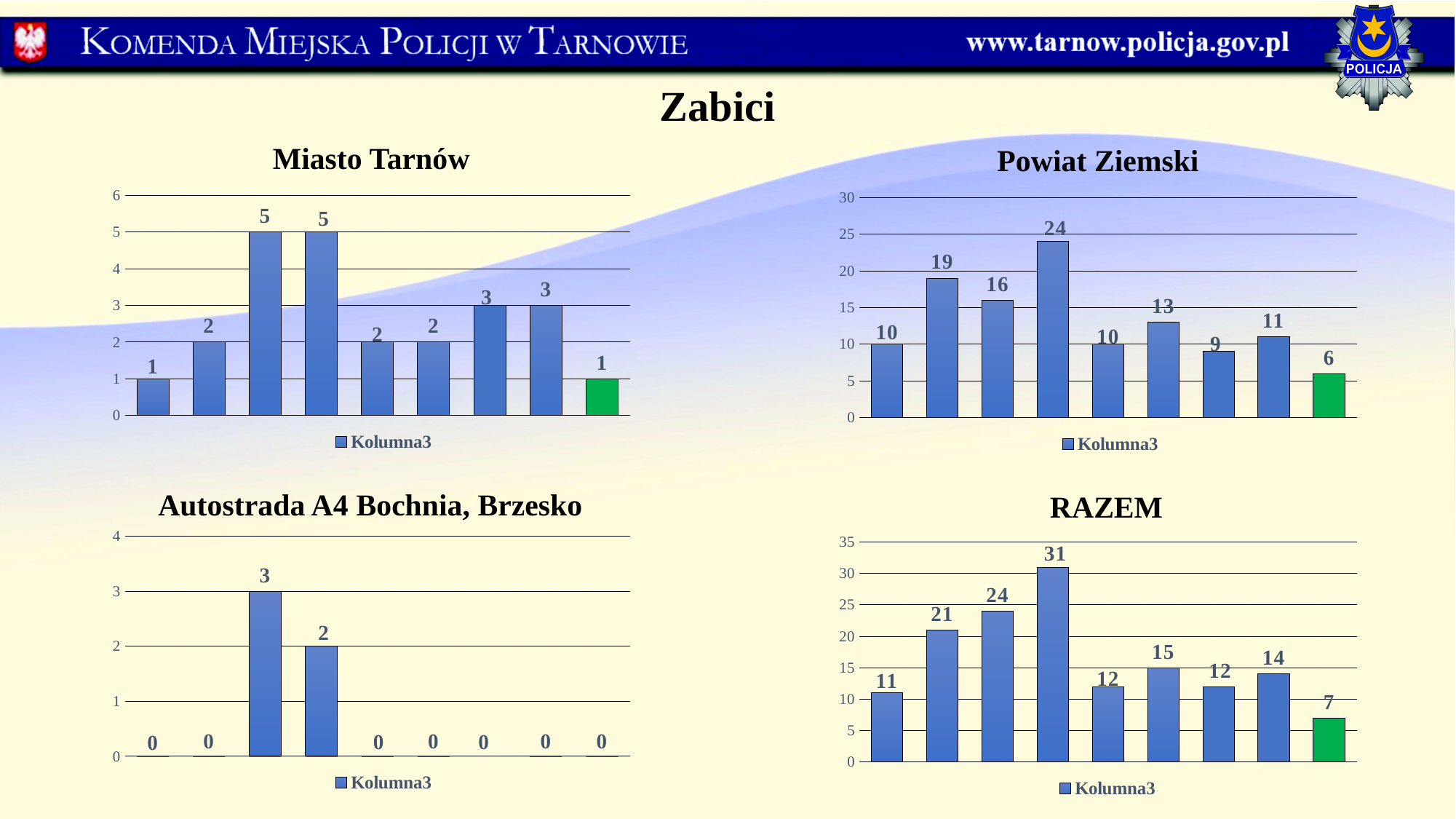
In the Autostrada A4 Bochnia, Brzesko chart, how many bars have a value of 0? 7 How many bars are plotted in the Powiat Ziemski chart? 9 In the Miasto Tarnów chart, what is the value of the first bar? 1 In the Powiat Ziemski chart, what is the highest value shown? 24 In the RAZEM chart, what is the value of the green bar (the last bar)? 7 In the RAZEM chart, what is the lowest value shown? 7 In the Powiat Ziemski chart, is the fourth bar (24) larger or smaller than the second bar (19)? larger In the Autostrada A4 Bochnia, Brzesko chart, what is the highest value shown? 3 What is the legend entry shown under the Powiat Ziemski chart? Kolumna3 In the RAZEM chart, what is the difference between the highest bar (31) and the second bar (21)? 10 What type of chart is the Miasto Tarnów chart? bar chart How many series does the legend of the RAZEM chart list? 1